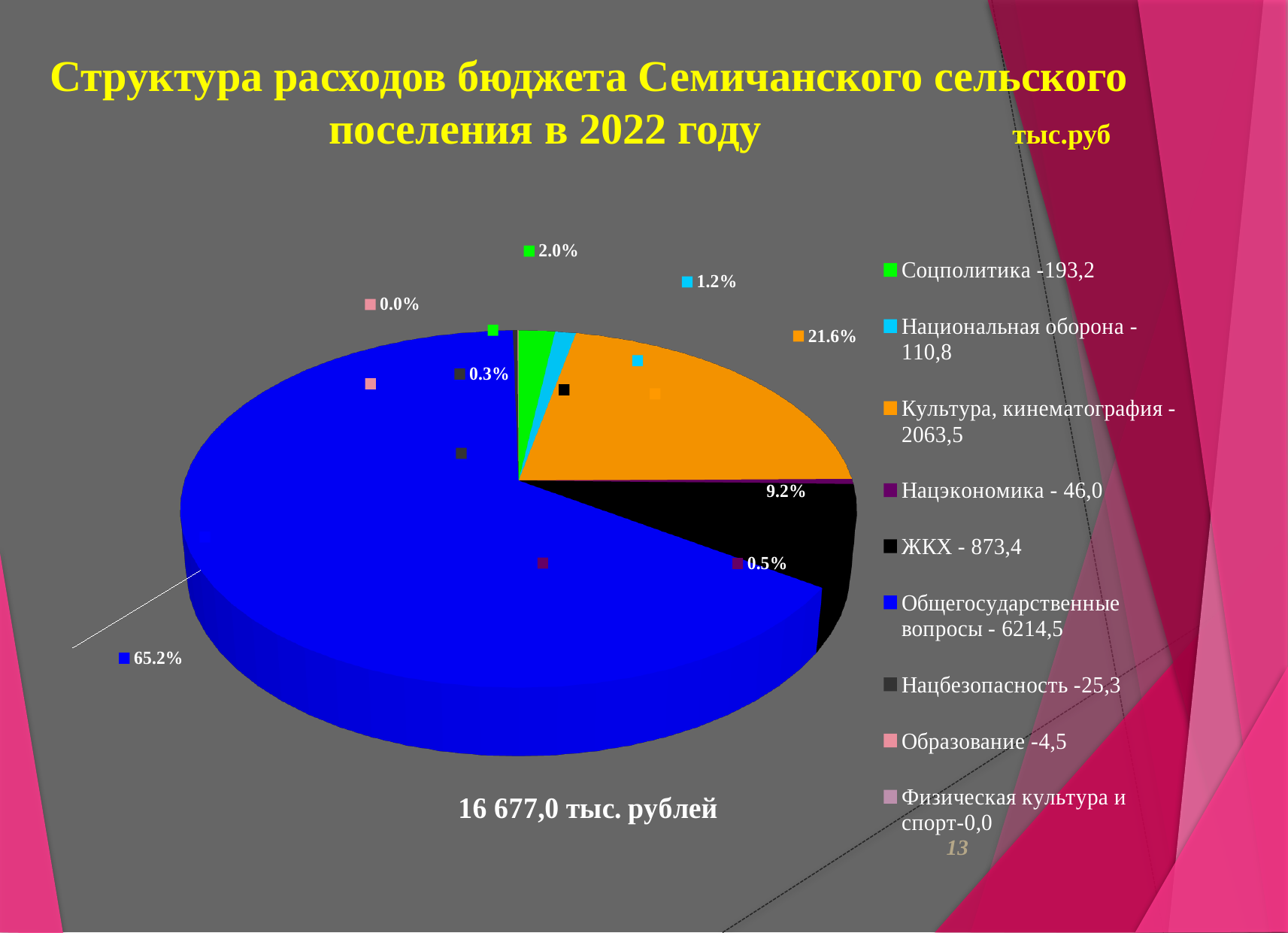
Which is larger: Культура, кинематография or ЖКХ? Культура, кинематография What share of the pie does ЖКХ take? 9.2% What share of the pie does Национальная оборона take? 1.2% What value does the legend give for Нацэкономика? 46,0 What share of the pie does Общегосударственные вопросы take? 65.2% What kind of chart is shown on the slide? pie chart Which category has the largest slice of the pie? Общегосударственные вопросы How many categories does the legend list? 9 What value does the legend give for ЖКХ? 873,4 What is the difference between the values for Общегосударственные вопросы (6214,5) and Культура, кинематография (2063,5)? 4151,0